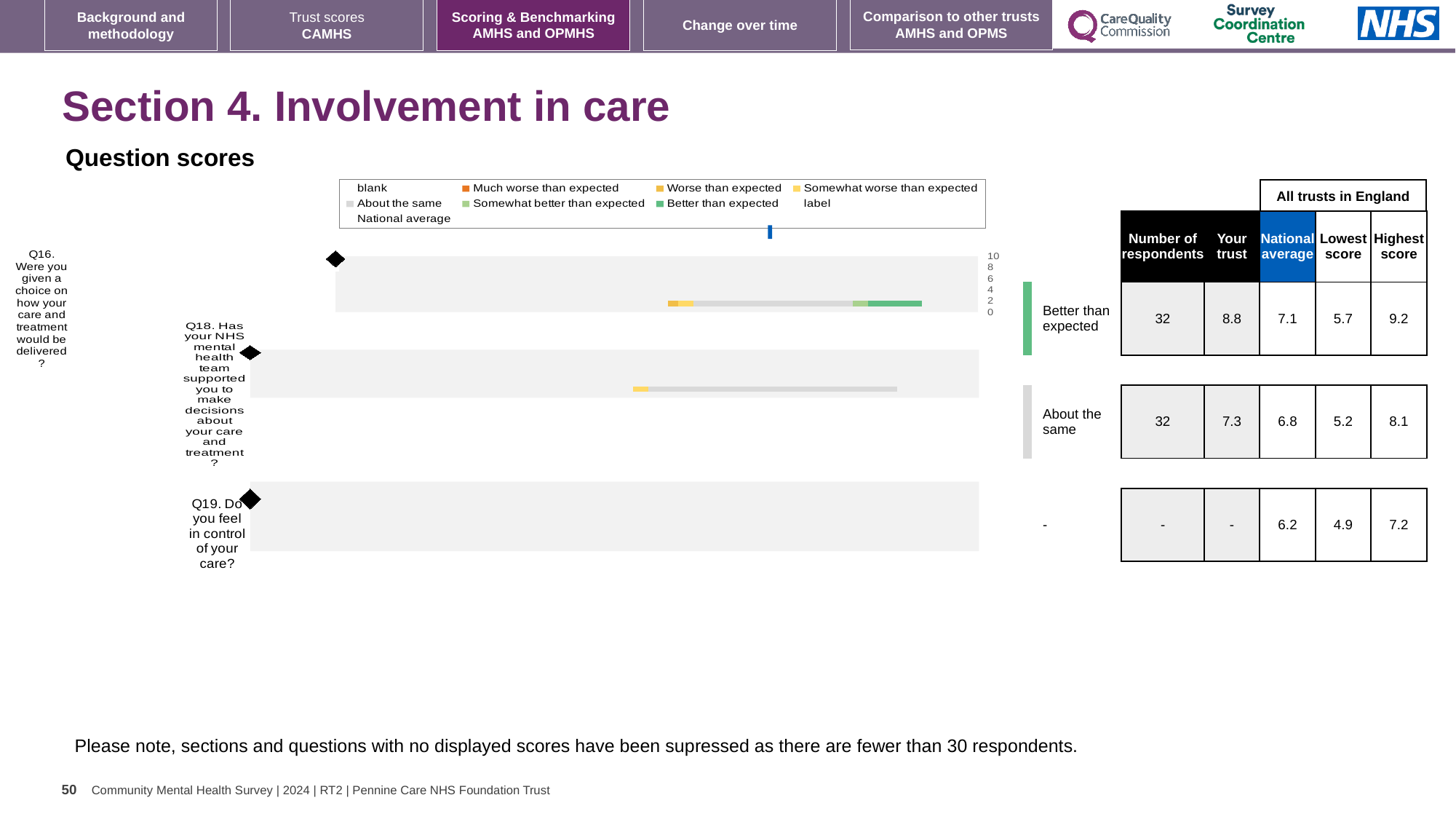
What is the 'Your trust' score for Q16? 8.8 Which benchmark category is Q16 rated as, according to the label beside its bar? Better than expected Which benchmark category is Q18 rated as, according to the label beside its bar? About the same What is the highest score across all trusts in England for Q19? 7.2 What colour does the legend use for 'Better than expected'? green What kind of chart is shown under 'Question scores'? bar chart How many questions are listed as categories on the chart? 3 What is the difference between the 'Your trust' score and the national average for Q16? 1.7 How many respondents answered Q18? 32 Which question has the higher 'Your trust' score, Q16 or Q18? Q16 What is the national average for Q18? 6.8 Which question has the lowest national average? Q19